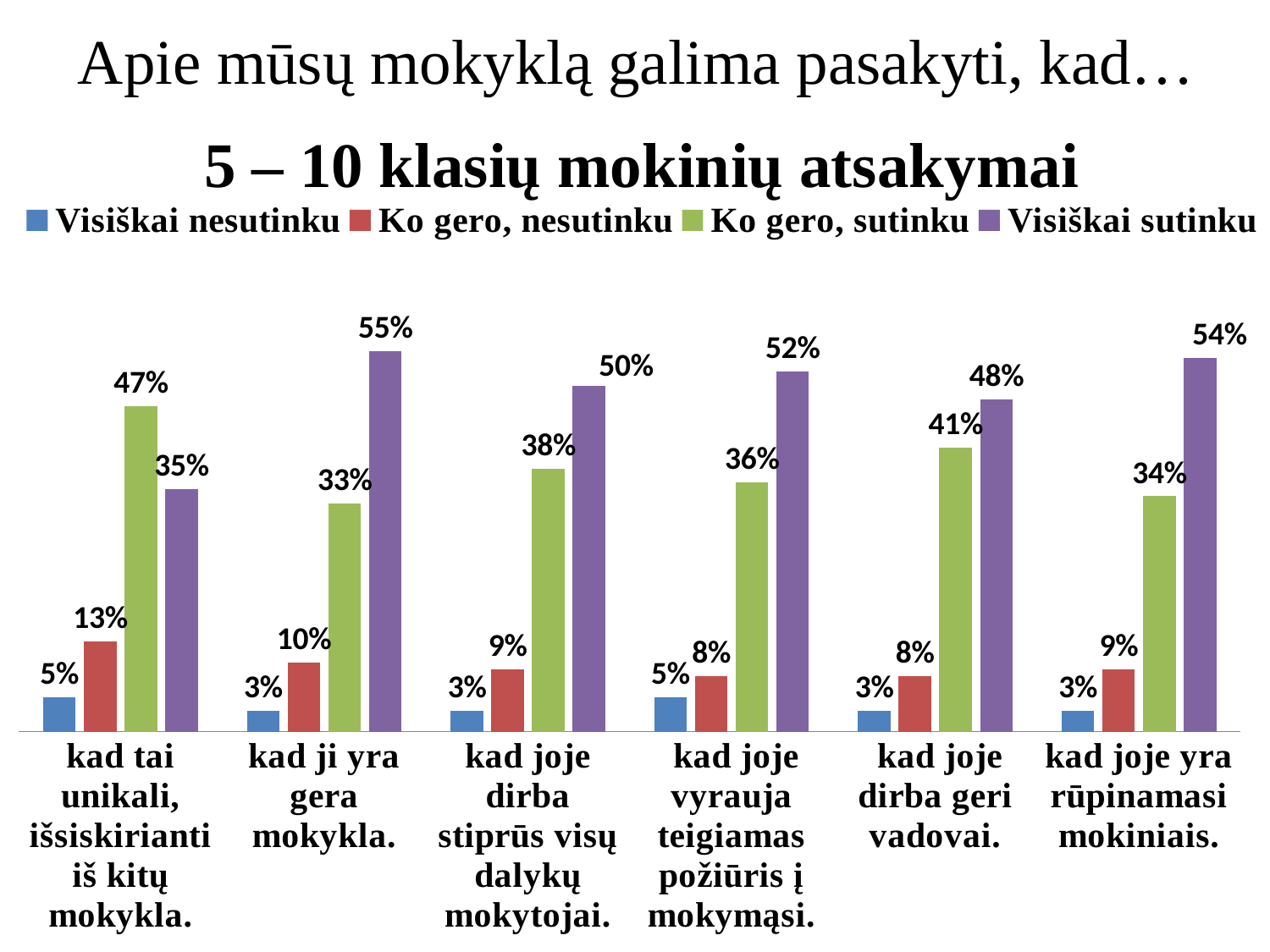
What is the difference between the "Visiškai sutinku" and "Ko gero, sutinku" values for "kad joje dirba geri vadovai."? 7% Which is larger for "kad joje vyrauja teigiamas požiūris į mokymąsi.": "Ko gero, sutinku" or "Visiškai sutinku"? Visiškai sutinku What is the value of "Ko gero, nesutinku" for "kad joje dirba stiprūs visų dalykų mokytojai."? 9% Which category has the lowest "Visiškai sutinku" value? kad tai unikali, išsiskirianti iš kitų mokykla. How many categories are shown on the x axis? 6 What is the value of "Visiškai sutinku" for "kad ji yra gera mokykla."? 55% What is the title of the chart? 5 – 10 klasių mokinių atsakymai What is the value of "Ko gero, sutinku" for "kad tai unikali, išsiskirianti iš kitų mokykla."? 47% What type of chart is shown on the slide? bar chart How many series does the legend list? 4 Which category has the highest "Ko gero, nesutinku" value? kad tai unikali, išsiskirianti iš kitų mokykla. Which category has the highest "Visiškai sutinku" value? kad ji yra gera mokykla.